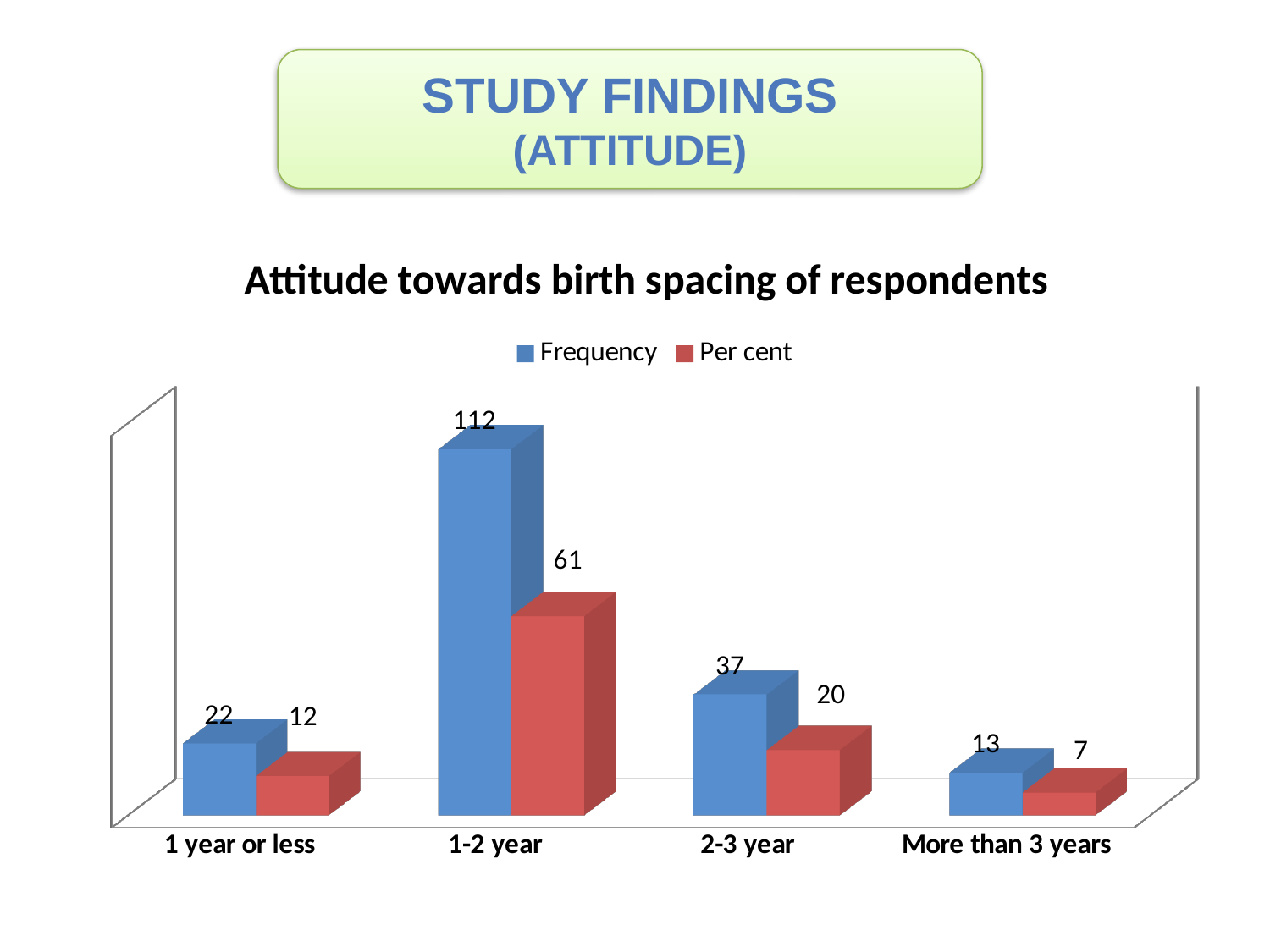
Which is larger, the Frequency for 1 year or less or the Frequency for More than 3 years? 1 year or less What is the Per cent value for the 2-3 year category? 20 What is the Frequency value for More than 3 years? 13 How many series does the legend list? 2 Which category has the highest Frequency? 1-2 year What kind of chart is shown on the slide? Bar chart Which category has the lowest Per cent value? More than 3 years How many categories are shown on the x axis? 4 What is the Per cent value for 1 year or less? 12 What is the Frequency value for the 1-2 year category? 112 What is the title of the chart? Attitude towards birth spacing of respondents What is the difference between the Frequency values for 1-2 year and 2-3 year? 75